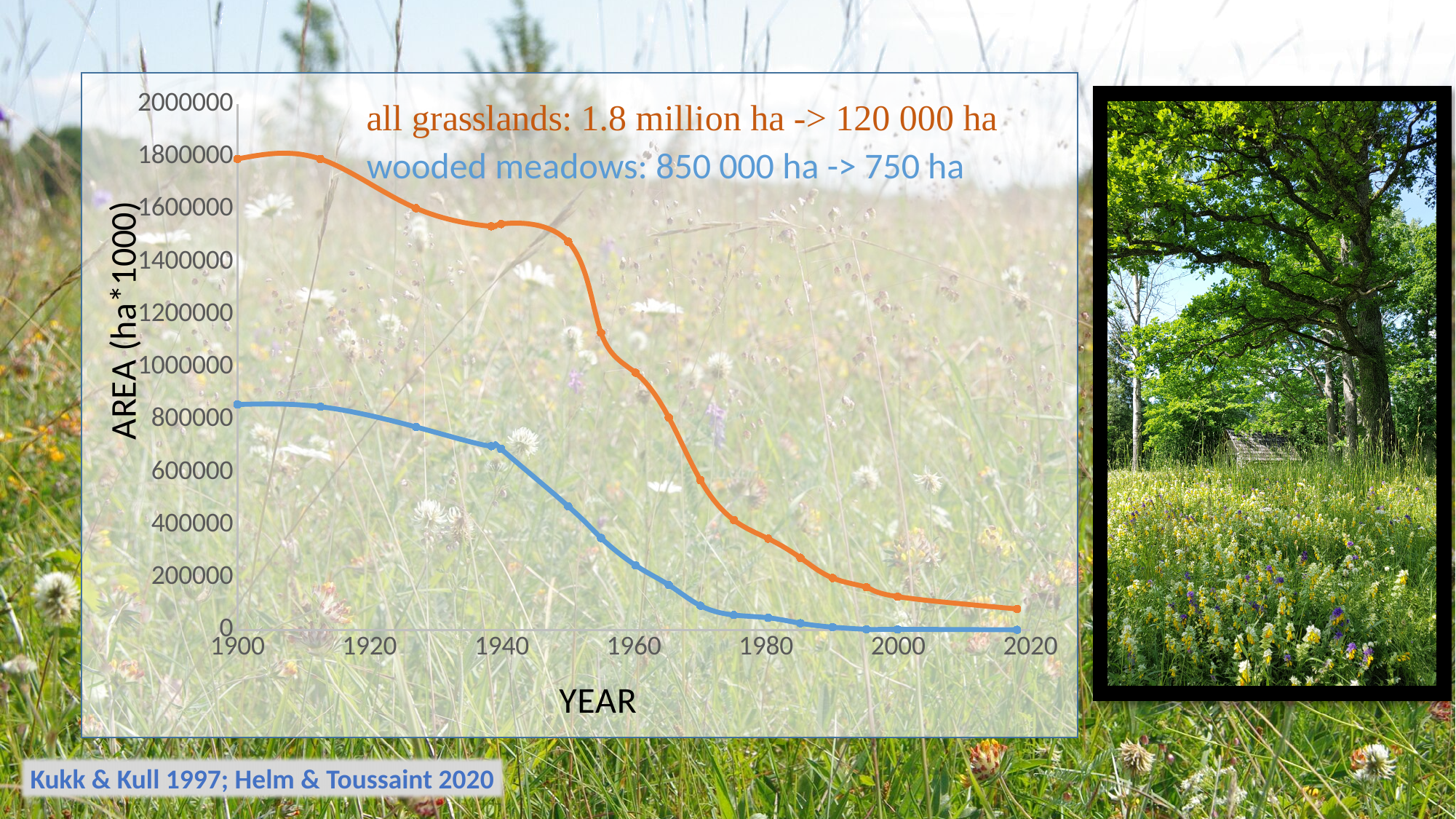
Is the value for all grasslands in 1900 greater or less than 1600000? greater Is the value for all grasslands in 1980 greater or less than 400000? less According to the text on the chart, what area did all grasslands decline to? 120 000 ha What type of chart is shown on the slide? line chart In 1960, which series has the larger value: all grasslands or wooded meadows? all grasslands What is the label of the y axis? AREA (ha*1000) How many data series are plotted on the chart? 2 Is the value for wooded meadows in 1980 greater or less than 200000? less Do the values for all grasslands rise or fall from 1900 to 2020? fall According to the text on the chart, what area did wooded meadows decline to? 750 ha